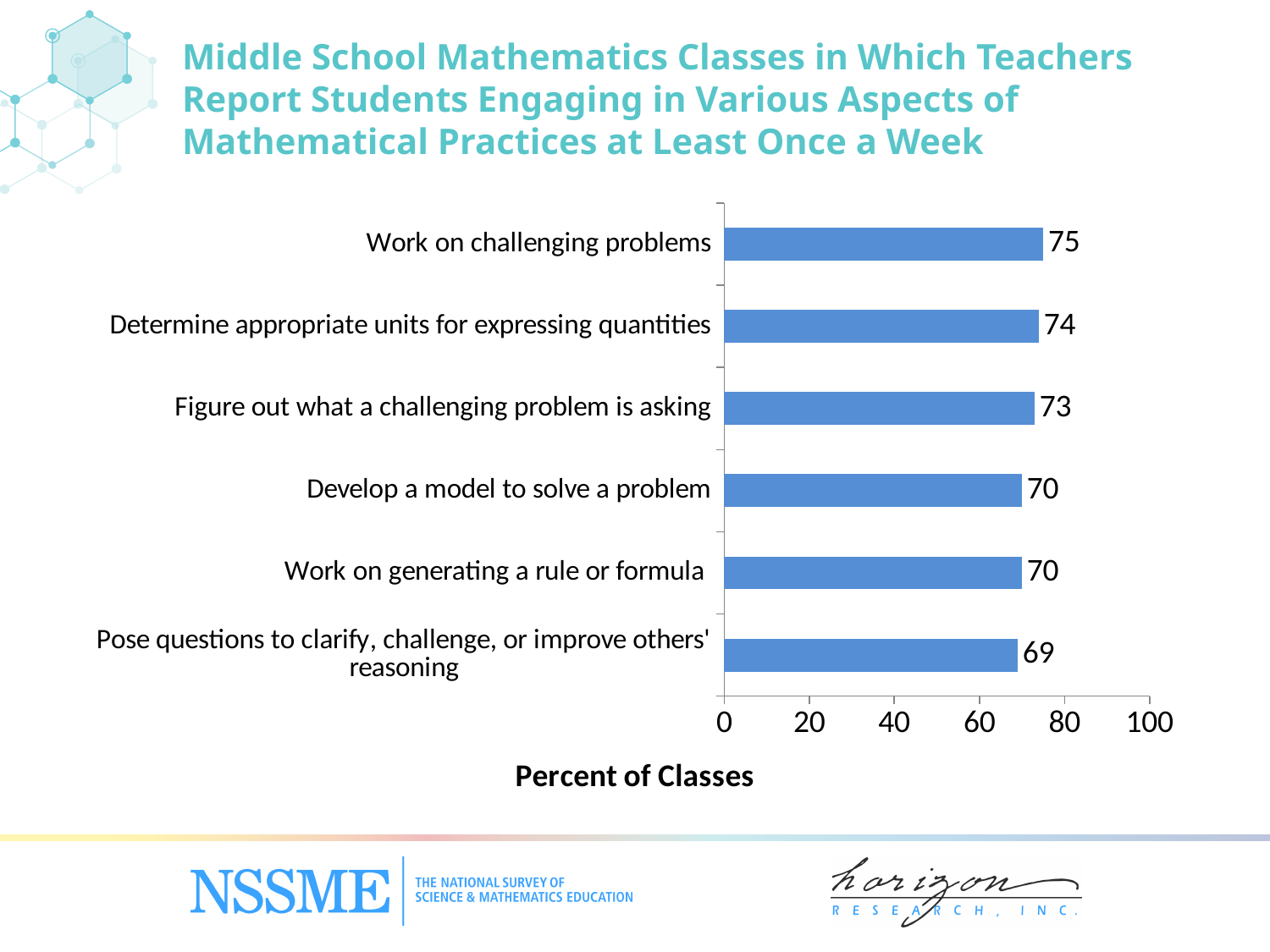
Which is larger: the value for "Determine appropriate units for expressing quantities" or the value for "Develop a model to solve a problem"? Determine appropriate units for expressing quantities What is the difference between the values for "Determine appropriate units for expressing quantities" and "Work on generating a rule or formula"? 4 Which category has the highest percent of classes? Work on challenging problems What kind of chart is shown on the slide? Bar chart What is the difference between the values for "Work on challenging problems" and "Pose questions to clarify, challenge, or improve others' reasoning"? 6 How many categories are shown in the chart? 6 What is the value for "Pose questions to clarify, challenge, or improve others' reasoning"? 69 What is the label of the horizontal axis? Percent of Classes What is the value for "Develop a model to solve a problem"? 70 Which category has the lowest percent of classes? Pose questions to clarify, challenge, or improve others' reasoning What percent of classes is reported for "Work on challenging problems"? 75 What is the value for "Figure out what a challenging problem is asking"? 73